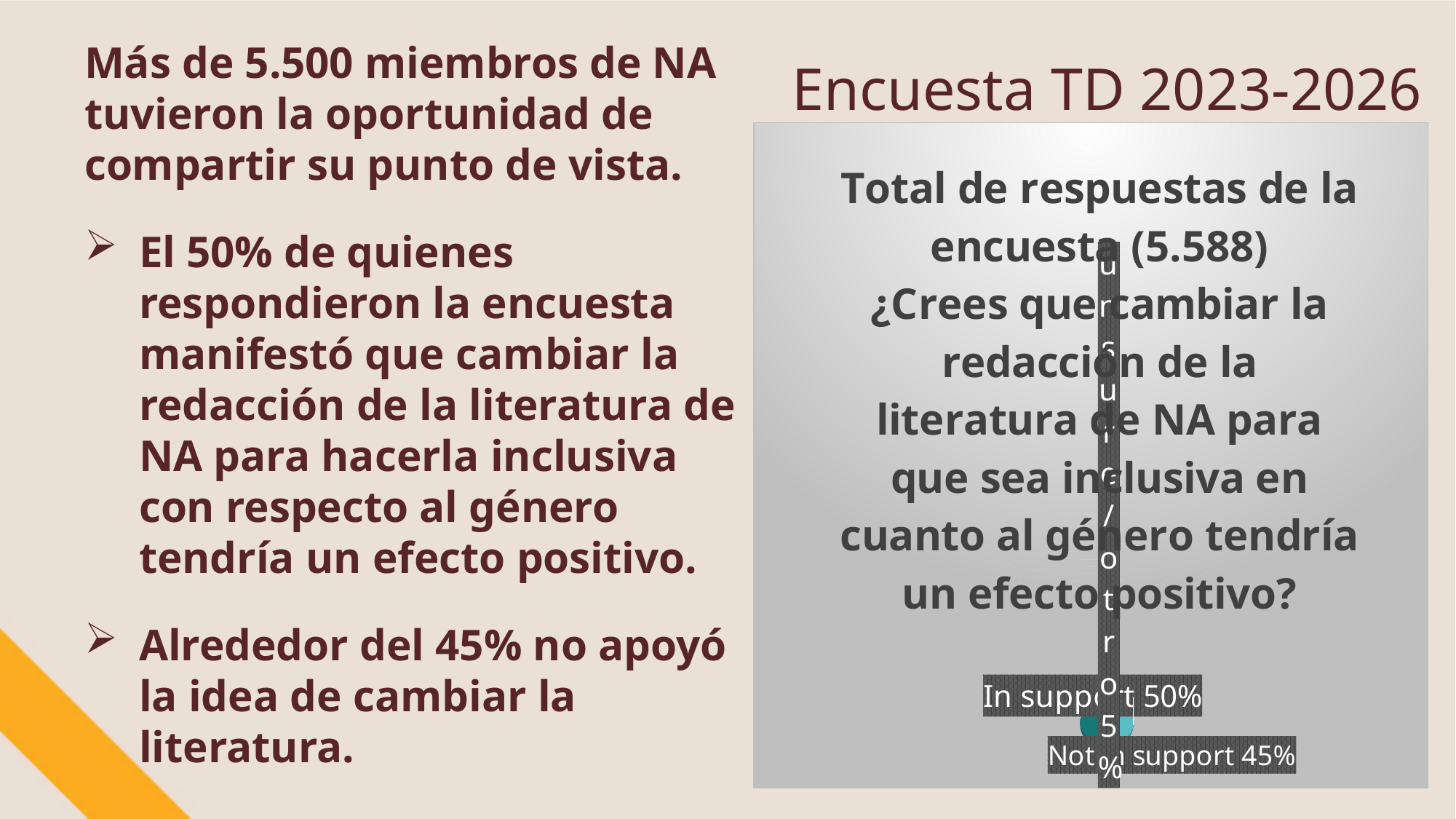
How many categories are labelled in the chart? 3 What percentage is shown for the "Not in support" category? 45% What share of responses does the "In support" category represent? 50% According to the chart title, what is the total number of survey responses? 5.588 Which category has the larger value, "In support" or "Not in support"? In support What percentage is shown for the "In support" category? 50% Which category has the highest percentage in the chart? In support What is the difference between the "In support" and "Not in support" percentages? 5%